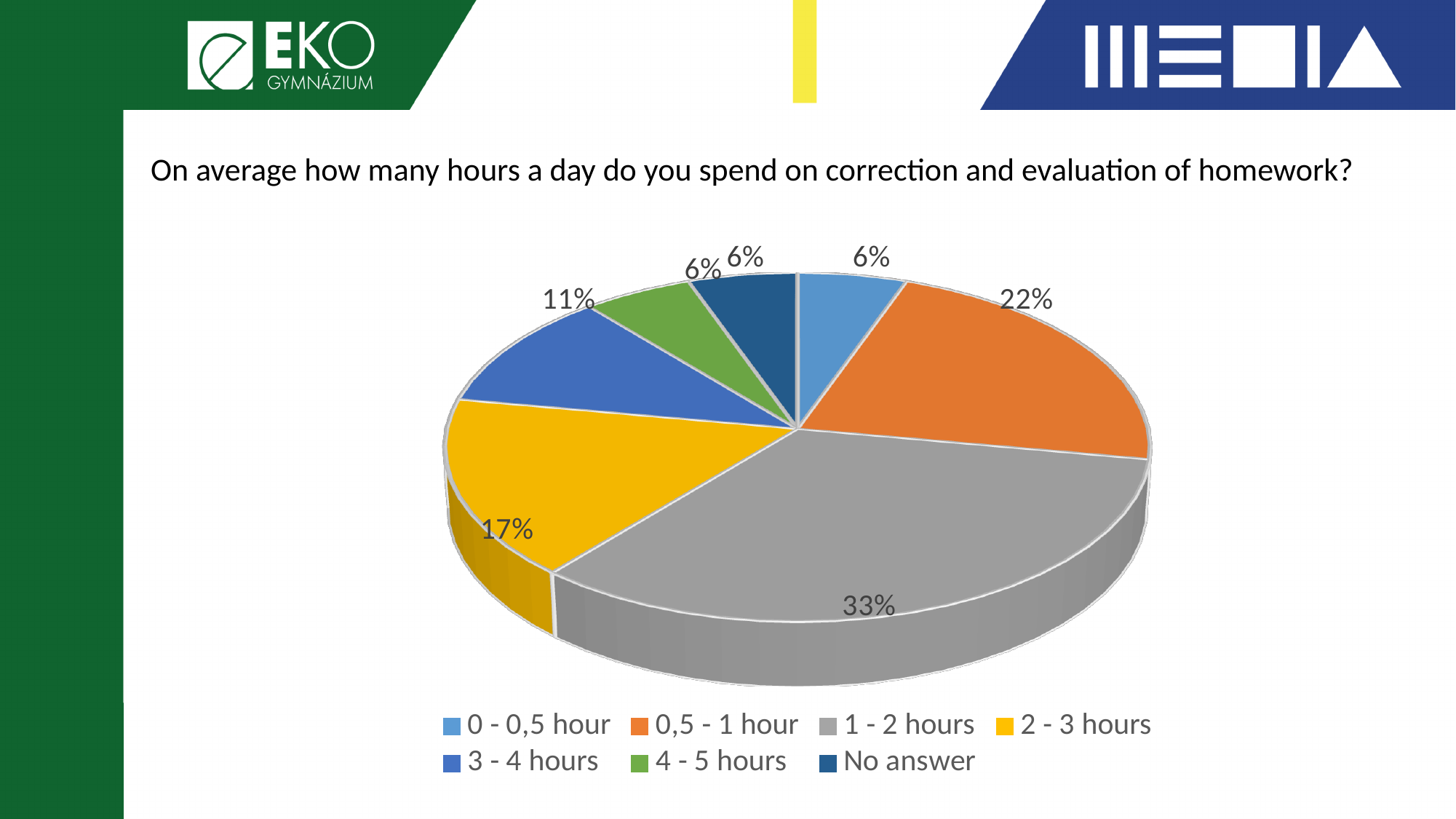
What percentage of respondents gave no answer? 6% What percentage of respondents chose 3 - 4 hours? 11% What type of chart is shown on the slide? pie chart What is the difference in percentage points between the 1 - 2 hours slice and the 0,5 - 1 hour slice? 11 What share of respondents spend 1 - 2 hours a day on correction and evaluation of homework? 33% What colour is the slice for 1 - 2 hours? gray What question is the chart answering, according to the title above it? On average how many hours a day do you spend on correction and evaluation of homework? What percentage of respondents chose 2 - 3 hours? 17% Which is larger, the share for 2 - 3 hours or the share for 3 - 4 hours? 2 - 3 hours What percentage of respondents chose 0,5 - 1 hour? 22% Which category has the largest share of the pie? 1 - 2 hours How many categories does the legend list? 7